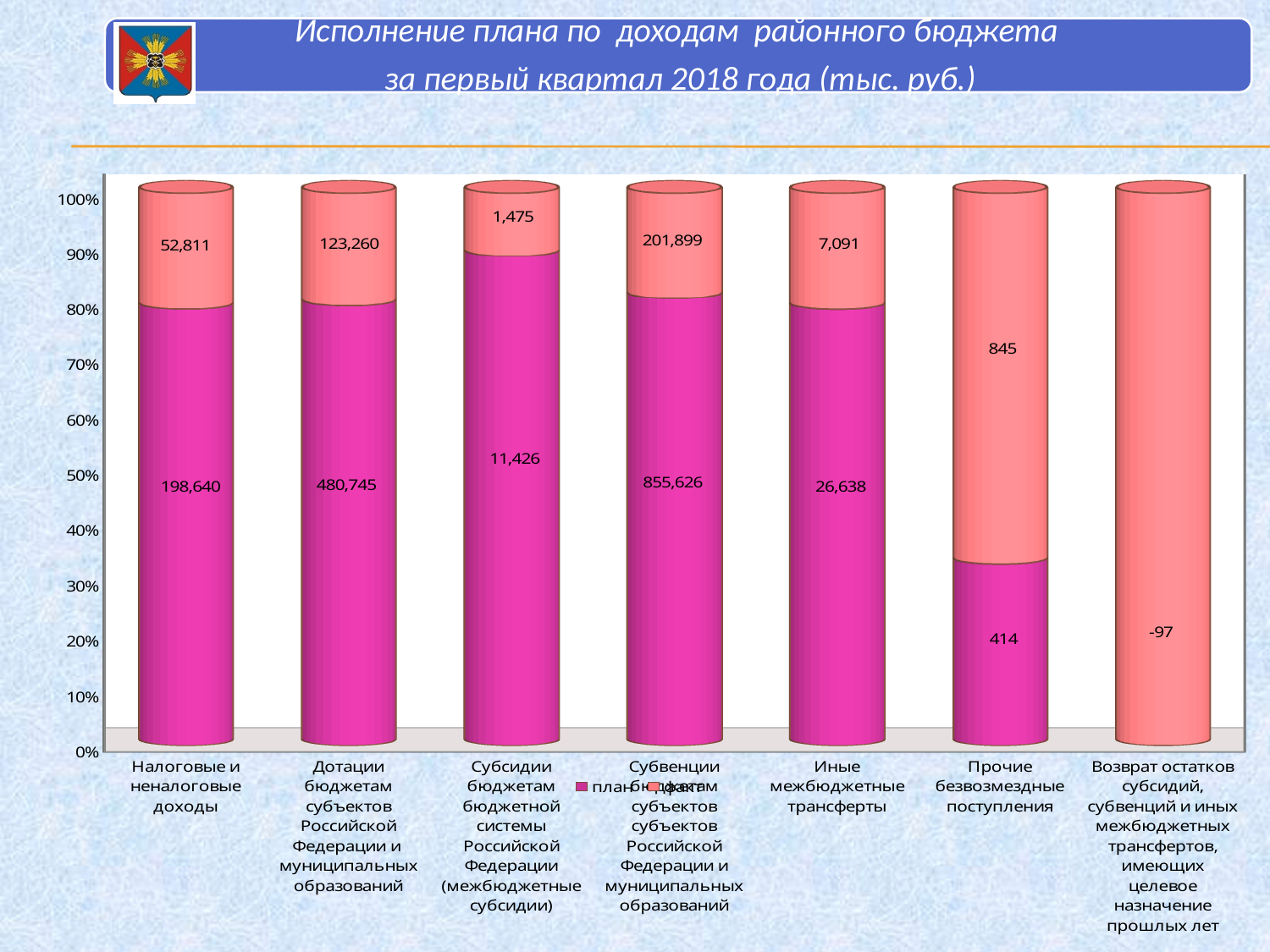
What kind of chart is shown on the slide? Stacked bar chart How many series does the legend list? 2 Which is larger for Иные межбюджетные трансферты, the план value or the факт value? план What is the план value for Налоговые и неналоговые доходы? 198,640 What is the факт value for Возврат остатков субсидий, субвенций и иных межбюджетных трансфертов, имеющих целевое назначение прошлых лет? -97 What is the факт value for Дотации бюджетам субъектов Российской Федерации и муниципальных образований? 123,260 What is the difference between the факт and план values for Прочие безвозмездные поступления? 431 Which category has the lowest факт value? Возврат остатков субсидий, субвенций и иных межбюджетных трансфертов, имеющих целевое назначение прошлых лет What is the план value for Прочие безвозмездные поступления? 414 What is the difference between the план and факт values for Налоговые и неналоговые доходы? 145,829 How many categories are shown on the x axis? 7 Which category has the highest план value? Субвенции бюджетам субъектов Российской Федерации и муниципальных образований